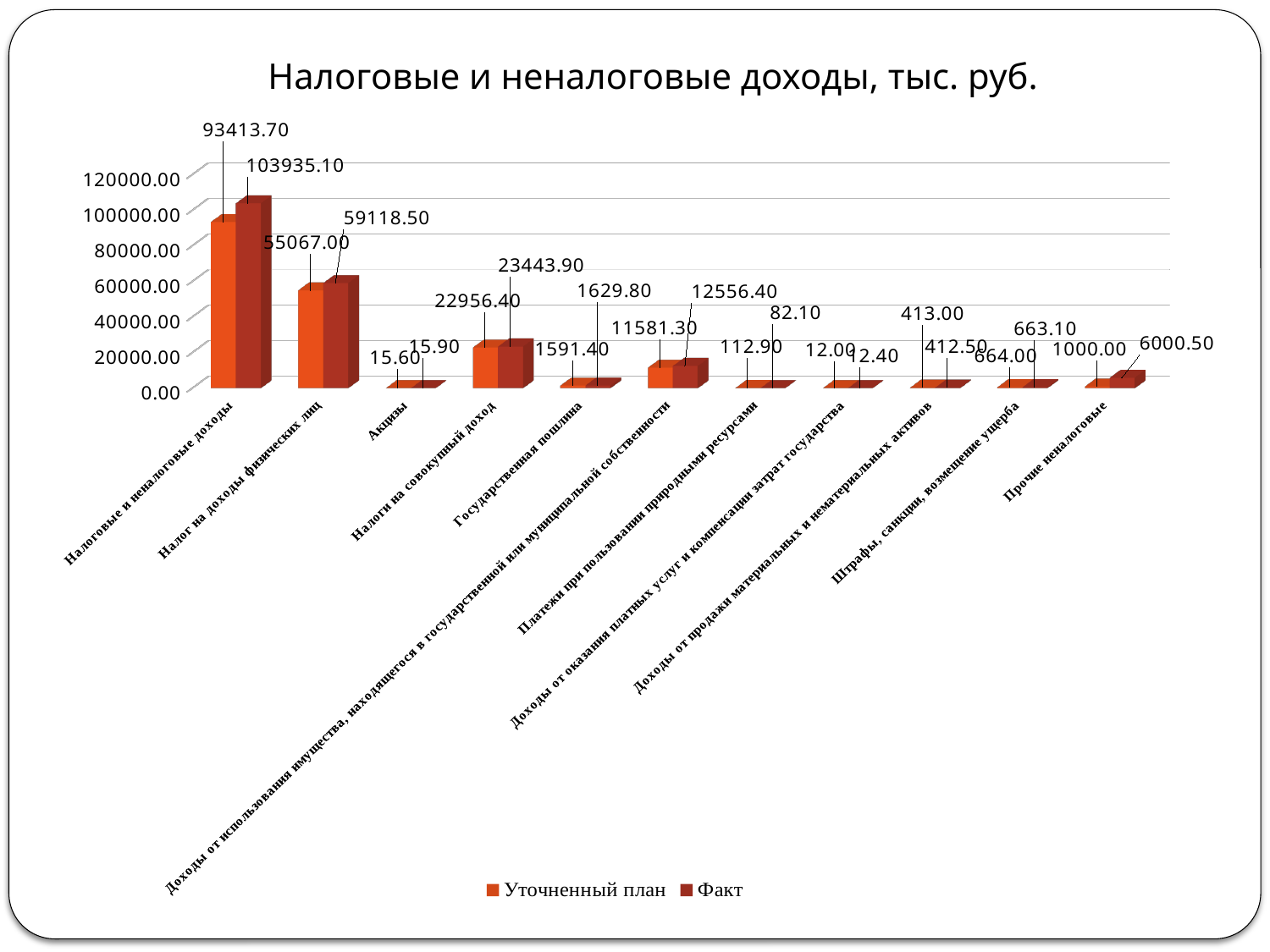
What type of chart is shown on the slide? Bar chart How many series does the legend list? 2 How many categories are shown on the x axis? 11 Is the Факт value for Налог на доходы физических лиц greater or less than 40000.00? greater What is the Уточненный план value for Налоги на совокупный доход? 22956.40 What is the Факт value for Прочие неналоговые? 6000.50 Which category has the lowest Уточненный план value? Доходы от оказания платных услуг и компенсации затрат государства Which category has the highest Факт value? Налоговые и неналоговые доходы What is the Факт value for Налог на доходы физических лиц? 59118.50 What is the difference between the Факт and Уточненный план values for Налоговые и неналоговые доходы? 10521.40 For Платежи при пользовании природными ресурсами, which is larger: Уточненный план or Факт? Уточненный план What is the Уточненный план value for Акцизы? 15.60